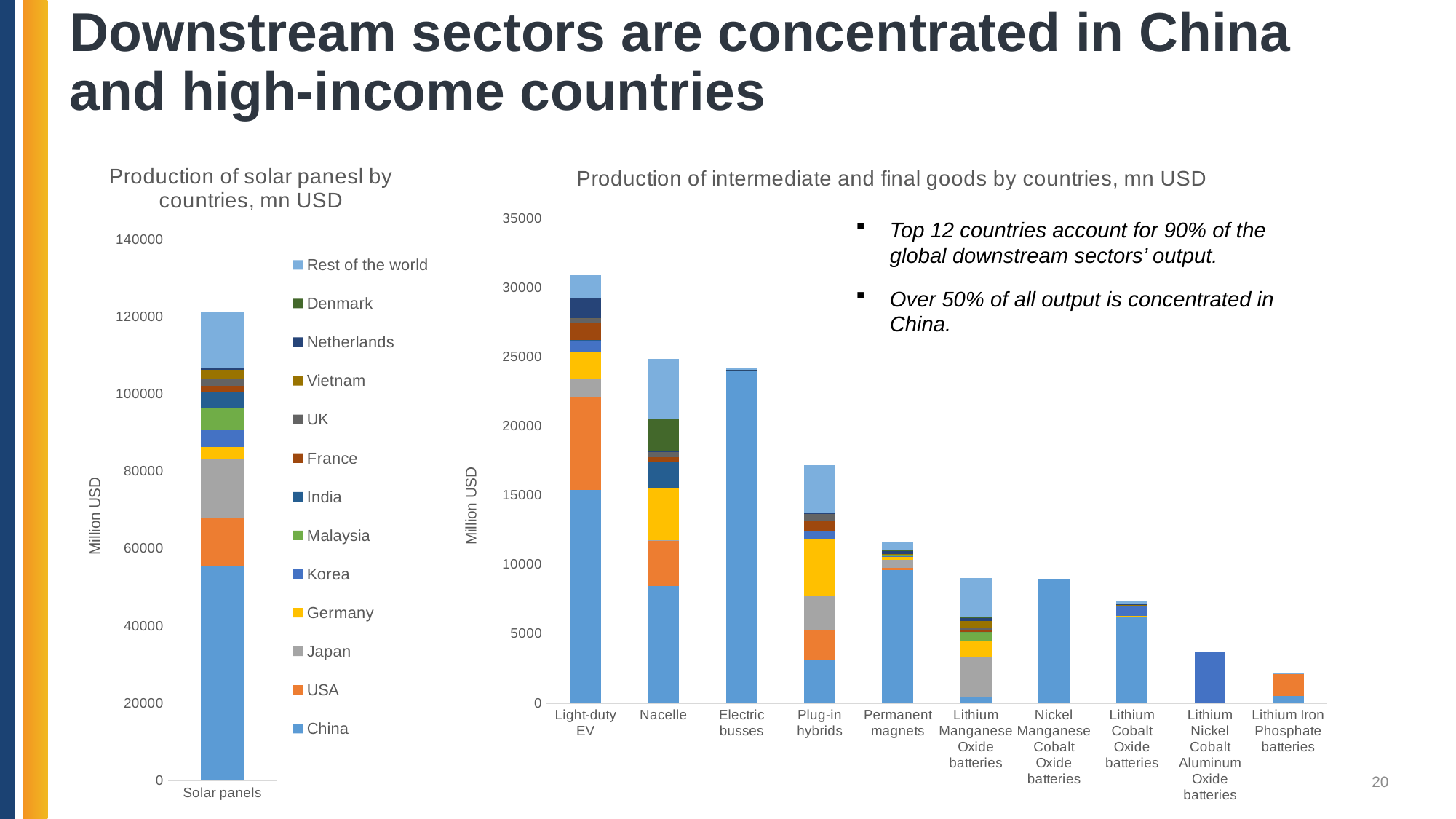
How many categories are shown on the x axis of the 'Production of intermediate and final goods by countries, mn USD' chart? 10 What kind of chart is the 'Production of solar panesl by countries, mn USD' chart? stacked bar chart In the 'Production of intermediate and final goods by countries, mn USD' chart, do the bar totals generally rise or fall from left to right? fall In the 'Production of intermediate and final goods by countries, mn USD' chart, which category has the highest total? Light-duty EV How many series does the legend of the 'Production of solar panesl by countries, mn USD' chart list? 13 In the 'Production of intermediate and final goods by countries, mn USD' chart, is the total for Nickel Manganese Cobalt Oxide batteries greater or less than 10000? less In the 'Production of intermediate and final goods by countries, mn USD' chart, which category has the lowest total? Lithium Iron Phosphate batteries In the 'Production of intermediate and final goods by countries, mn USD' chart, is the total for Electric busses greater or less than 25000? less In the 'Production of intermediate and final goods by countries, mn USD' chart, is the total for Plug-in hybrids greater or less than 15000? greater In the 'Production of intermediate and final goods by countries, mn USD' chart, which has the larger total, Nacelle or Plug-in hybrids? Nacelle What is the y-axis label of the 'Production of intermediate and final goods by countries, mn USD' chart? Million USD